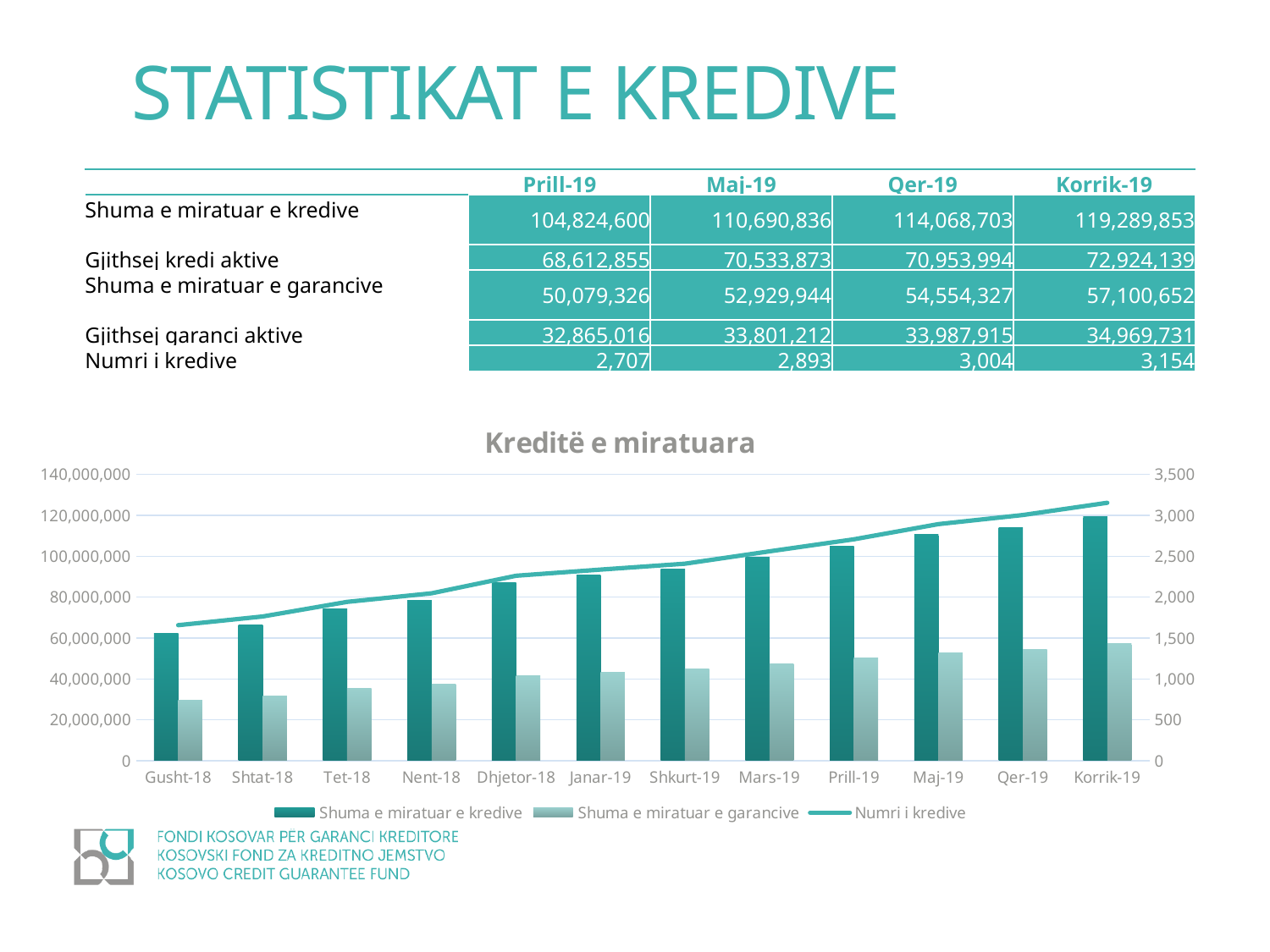
In the "Kreditë e miratuara" chart, is the value for Shuma e miratuar e kredive in Dhjetor-18 greater or less than 80,000,000? greater In the "Kreditë e miratuara" chart, which month has the highest value for Shuma e miratuar e kredive? Korrik-19 In the "Kreditë e miratuara" chart, which month has the lowest value for Shuma e miratuar e garancive? Gusht-18 In the "Kreditë e miratuara" chart, which is larger in Korrik-19: Shuma e miratuar e kredive or Shuma e miratuar e garancive? Shuma e miratuar e kredive What is the difference between Numri i kredive in Korrik-19 and Prill-19 as shown on the slide? 447 What is the value of Shuma e miratuar e kredive for Korrik-19 as shown on the slide? 119,289,853 In the "Kreditë e miratuara" chart, is the value for Shuma e miratuar e kredive in Tet-18 greater or less than 80,000,000? less How many months are shown on the x axis of the "Kreditë e miratuara" chart? 12 What type of chart is "Kreditë e miratuara"? Bar chart with a line How many series does the legend of the "Kreditë e miratuara" chart list? 3 In the "Kreditë e miratuara" chart, does the Numri i kredive line rise or fall from Gusht-18 to Korrik-19? Rises In the "Kreditë e miratuara" chart, is the value for Shuma e miratuar e garancive in Korrik-19 greater or less than 60,000,000? less